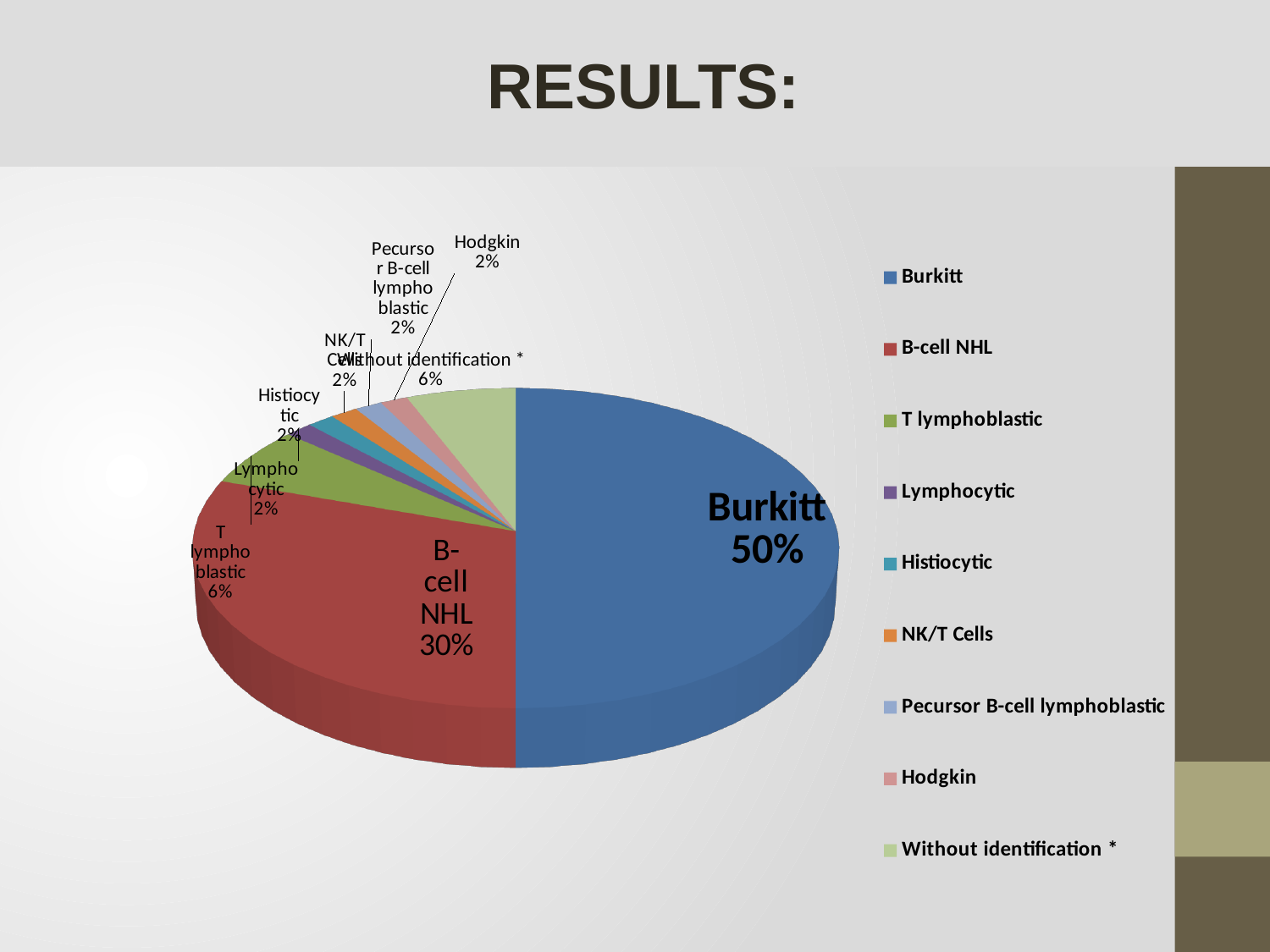
What type of chart is shown on the slide? Pie chart What percentage is shown for Without identification *? 6% What is the difference in percentage points between Burkitt and B-cell NHL? 20 What colour is the Burkitt slice in the pie chart? Blue What percentage of the pie chart does Burkitt represent? 50% How many categories does the legend of the pie chart list? 9 Which category has the largest share of the pie chart? Burkitt What is the combined share of Burkitt and B-cell NHL? 80% What percentage is shown for Hodgkin? 2% Which is larger, the share for T lymphoblastic or the share for Lymphocytic? T lymphoblastic What percentage of the pie chart does B-cell NHL represent? 30% What percentage is shown for T lymphoblastic? 6%